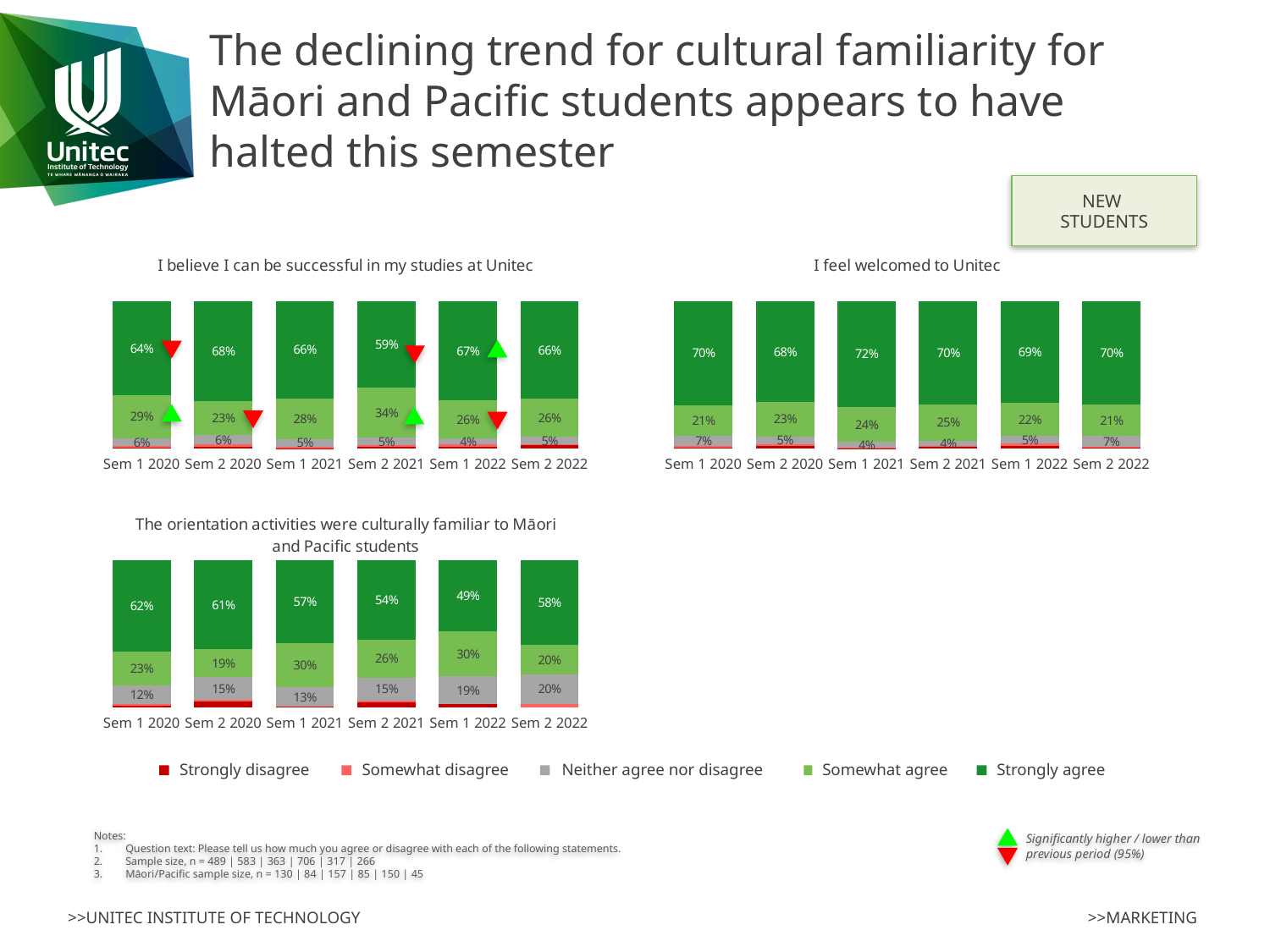
In the chart 'The orientation activities were culturally familiar to Māori and Pacific students', does the Strongly agree value rise or fall from Sem 1 2020 to Sem 1 2022? Fall In the chart 'I believe I can be successful in my studies at Unitec', what is the Strongly agree value for Sem 2 2021? 59% Which legend entry is shown in dark green? Strongly agree In the chart 'The orientation activities were culturally familiar to Māori and Pacific students', which semester has the lowest Strongly agree value? Sem 1 2022 In the chart 'I feel welcomed to Unitec', what is the Somewhat agree value for Sem 2 2021? 25% What kind of chart is 'I believe I can be successful in my studies at Unitec'? Stacked bar chart In the chart 'I feel welcomed to Unitec', which semester has the highest Strongly agree value? Sem 1 2021 In the chart 'I believe I can be successful in my studies at Unitec', what is the difference between the Somewhat agree values for Sem 2 2021 and Sem 2 2020? 11% How many semesters are shown on the x axis of the chart 'I feel welcomed to Unitec'? 6 In the chart 'The orientation activities were culturally familiar to Māori and Pacific students', what is the Neither agree nor disagree value for Sem 1 2022? 19% How many series does the legend list? 5 In the chart 'The orientation activities were culturally familiar to Māori and Pacific students', is the Strongly agree value higher in Sem 1 2020 or Sem 2 2022? Sem 1 2020